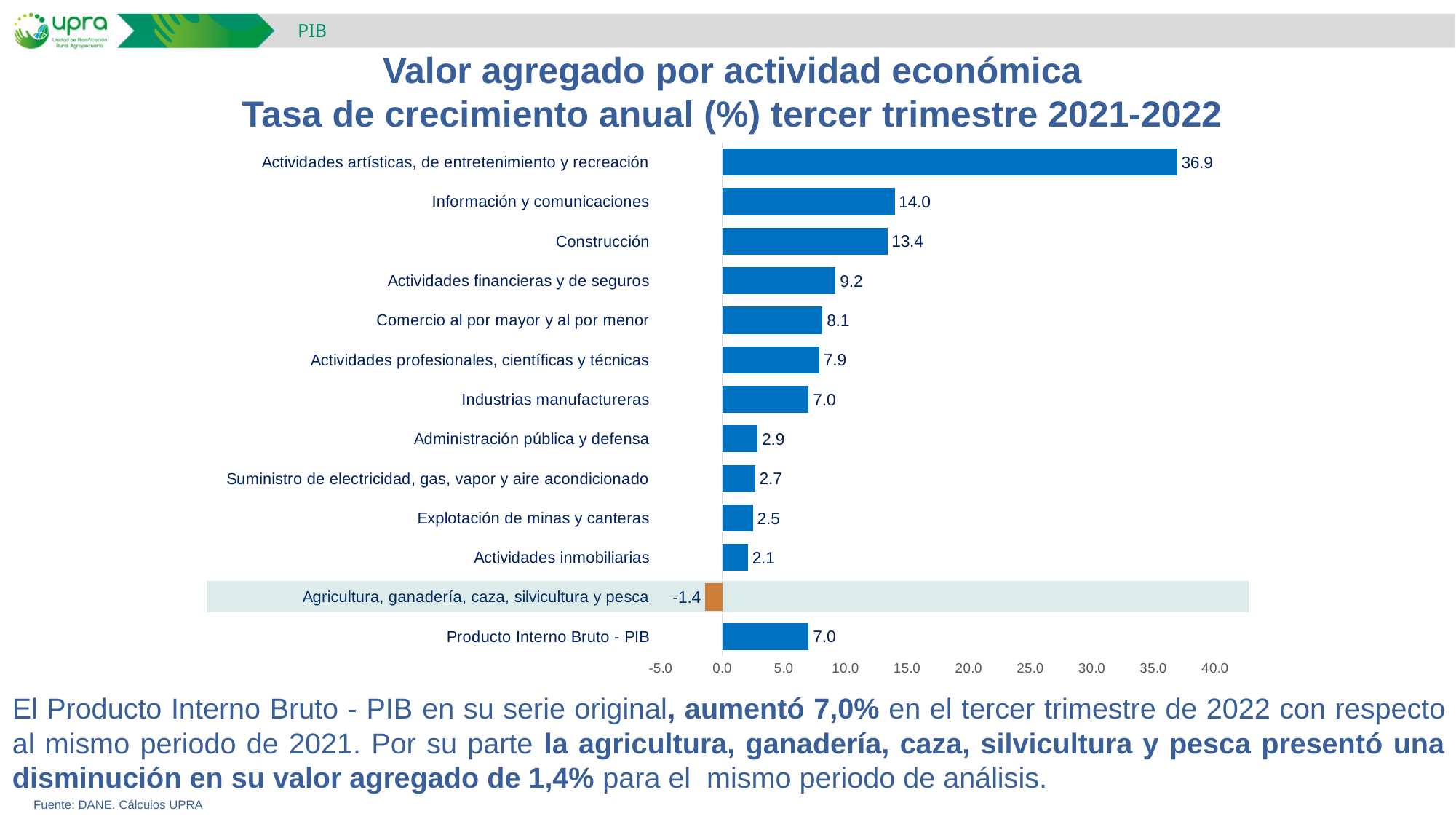
What is the difference between the values for Información y comunicaciones and Construcción? 0.6 Which category has the lowest value in the chart? Agricultura, ganadería, caza, silvicultura y pesca What is the annual growth rate shown for Construcción? 13.4 What is the value shown for Producto Interno Bruto - PIB? 7.0 Which bar in the chart is coloured orange instead of blue? Agricultura, ganadería, caza, silvicultura y pesca What is the difference between the value for Actividades artísticas, de entretenimiento y recreación and the value for Producto Interno Bruto - PIB? 29.9 Is the value for Actividades artísticas, de entretenimiento y recreación greater or less than 35.0? greater Which activity has the highest growth rate in the chart? Actividades artísticas, de entretenimiento y recreación What type of chart is shown on the slide? Bar chart Which has a larger value: Comercio al por mayor y al por menor or Actividades financieras y de seguros? Actividades financieras y de seguros What is the value shown for Agricultura, ganadería, caza, silvicultura y pesca? -1.4 How many categories (bars) are shown in the chart? 13